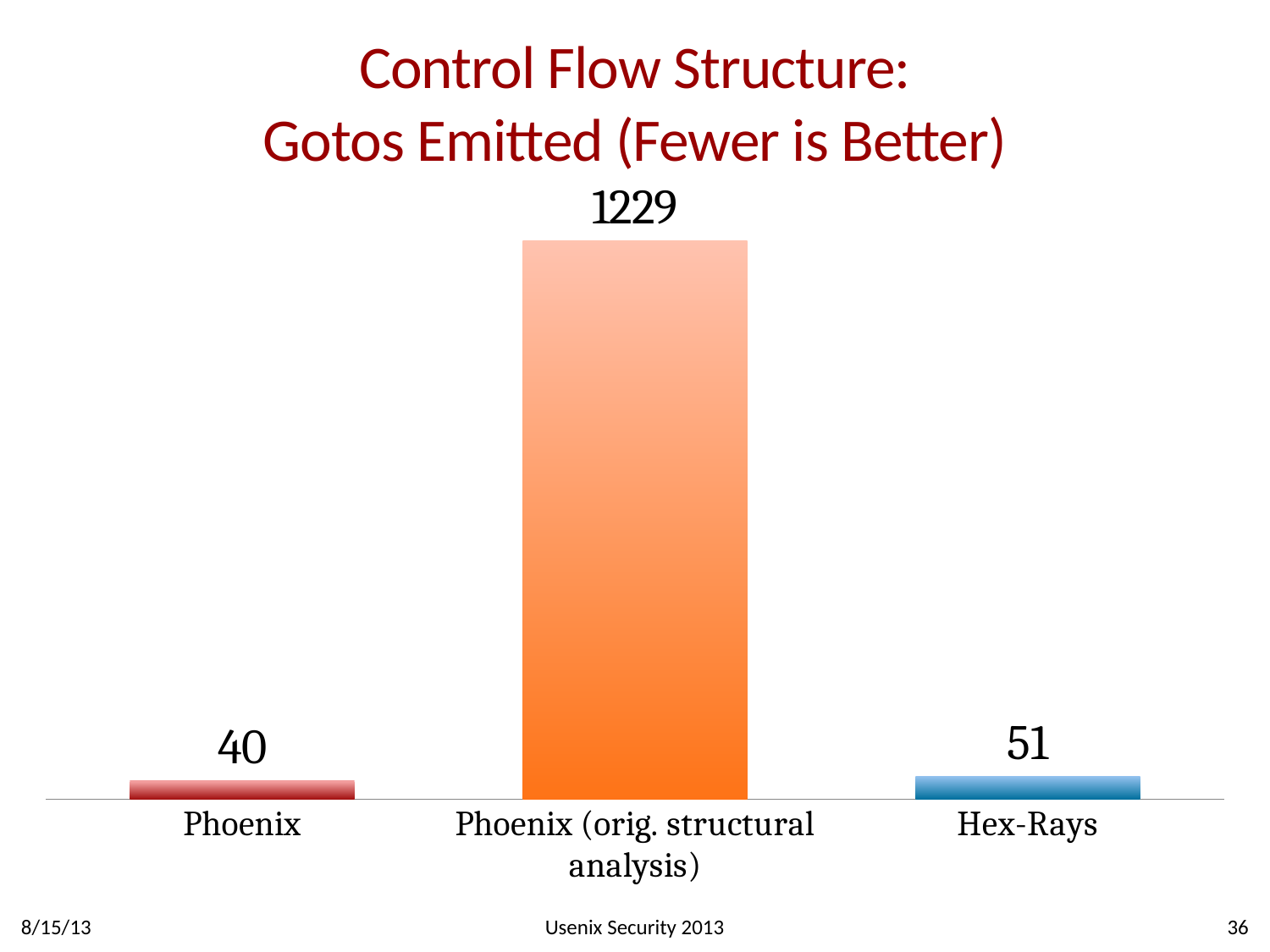
How many categories are shown in the chart? 3 Which emitted more gotos, Phoenix or Hex-Rays? Hex-Rays What colour is the bar for Hex-Rays? Blue Which category has the highest number of gotos emitted? Phoenix (orig. structural analysis) How many gotos were emitted by Phoenix? 40 How many gotos were emitted by Phoenix (orig. structural analysis)? 1229 What is the title of the chart on the slide? Control Flow Structure: Gotos Emitted (Fewer is Better) How many gotos were emitted by Hex-Rays? 51 What kind of chart is shown on the slide? Bar chart What is the difference in gotos emitted between Phoenix (orig. structural analysis) and Phoenix? 1189 Which category has the lowest number of gotos emitted? Phoenix What is the difference in gotos emitted between Hex-Rays and Phoenix? 11